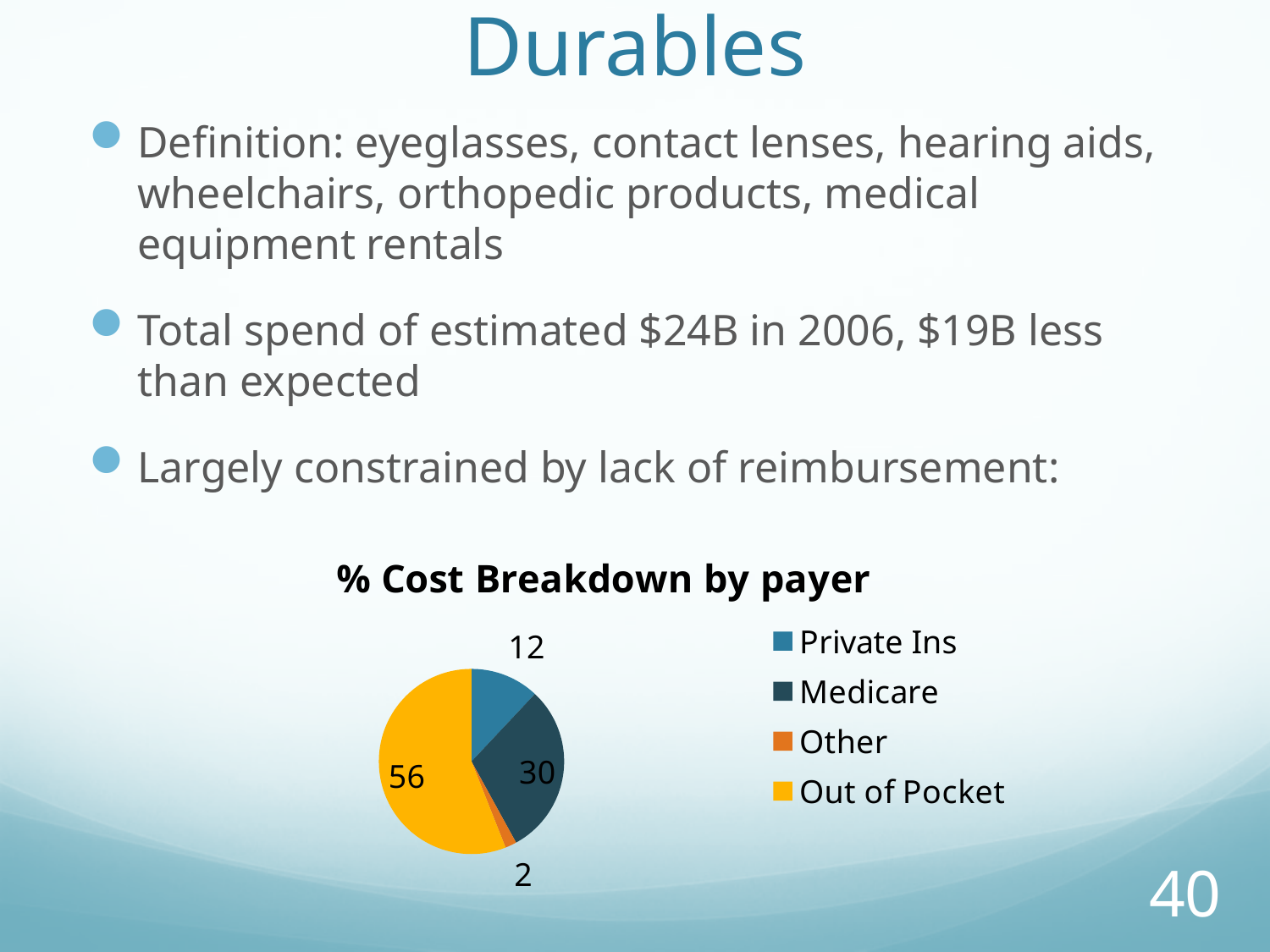
What is the value for Medicare? 30 What is the difference between the Out of Pocket and Medicare values? 26 What is the title of the chart? % Cost Breakdown by payer What is the value for Other? 2 What is the value for Private Ins? 12 Which is larger, the value for Medicare or the value for Private Ins? Medicare Which payer has the smallest slice of the pie? Other What colour is the Out of Pocket slice? yellow What type of chart is shown on the slide? pie chart Which payer has the largest slice of the pie? Out of Pocket What is the value for Out of Pocket? 56 How many categories does the legend list? 4